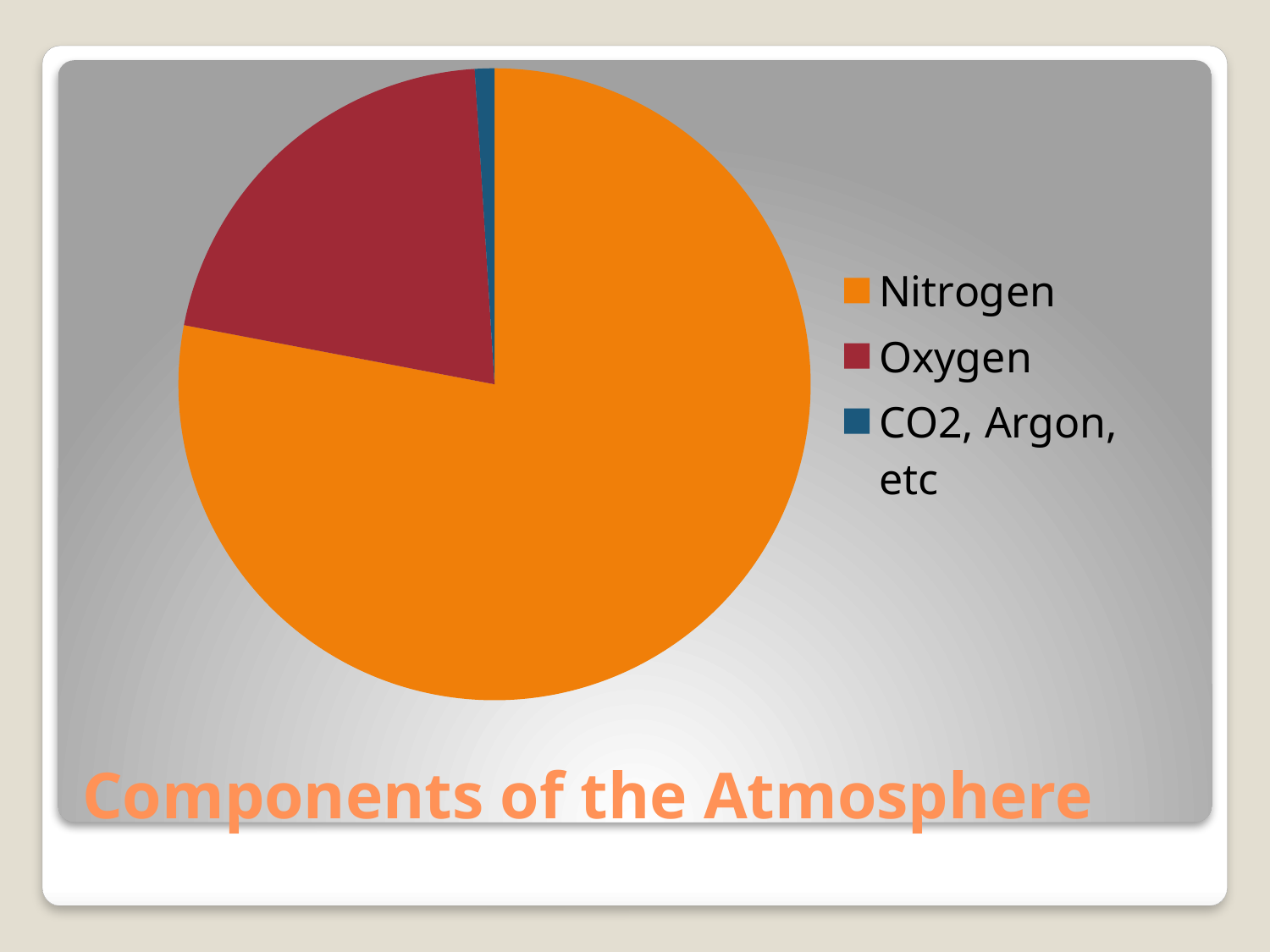
Which slice is larger, Oxygen or CO2, Argon, etc? Oxygen Which slice is larger, Oxygen or Nitrogen? Nitrogen Which component has the smallest slice of the pie? CO2, Argon, etc How many entries does the legend list? 3 What colour is the Oxygen slice? red What is the title of the chart? Components of the Atmosphere What kind of chart is shown on the slide? pie chart How many slices does the pie chart have? 3 Which component has the largest slice of the pie? Nitrogen